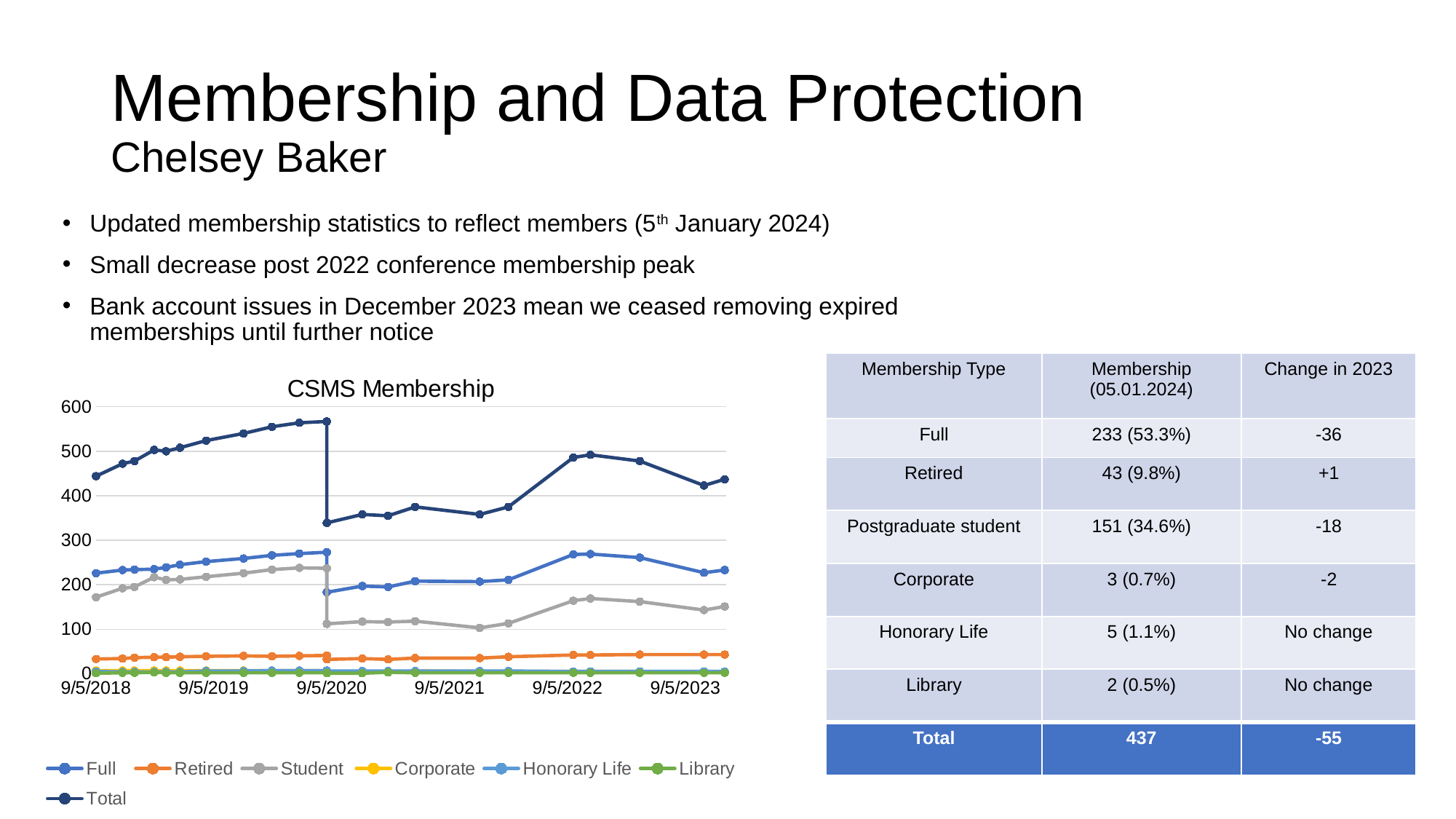
Which series in the CSMS Membership chart has the highest values throughout? Total In the CSMS Membership chart, is the Full value at 9/5/2018 greater or less than 200? greater In the CSMS Membership chart, does the Total series rise or fall between 9/5/2022 and 9/5/2023? fall In the CSMS Membership chart, which series is higher at 9/5/2022: Full or Student? Full What kind of chart is the CSMS Membership chart? line chart In the CSMS Membership chart, is the Retired value at 9/5/2023 greater or less than 100? less How many series does the legend of the CSMS Membership chart list? 7 What is the title of the chart on the slide? CSMS Membership In the CSMS Membership chart, is the Total value at 9/5/2020 (before the drop) greater or less than 500? greater How many date labels are shown on the x axis of the CSMS Membership chart? 6